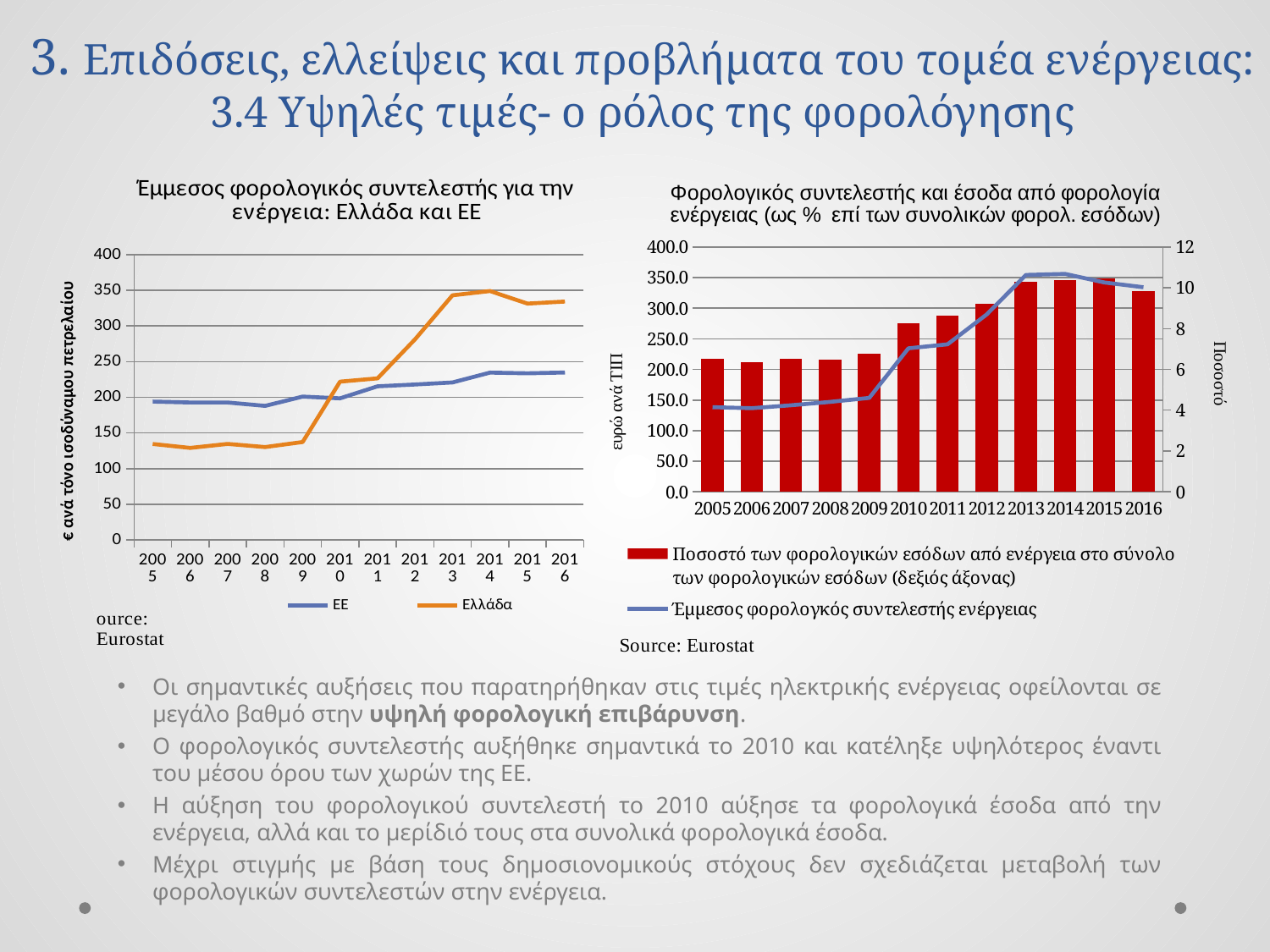
On the left chart (Έμμεσος φορολογικός συντελεστής για την ενέργεια: Ελλάδα και ΕΕ), what kind of chart is it? line chart On the right chart (Φορολογικός συντελεστής και έσοδα από φορολογία ενέργειας), how many series does the legend list? 2 On the right chart (Φορολογικός συντελεστής και έσοδα από φορολογία ενέργειας), is the bar value for 2013 on the right axis greater or less than 8? greater On the left chart (Έμμεσος φορολογικός συντελεστής για την ενέργεια: Ελλάδα και ΕΕ), is the value for Ελλάδα in 2014 greater or less than 300? greater On the left chart (Έμμεσος φορολογικός συντελεστής για την ενέργεια: Ελλάδα και ΕΕ), which series has the higher value in 2005, ΕΕ or Ελλάδα? ΕΕ On the left chart (Έμμεσος φορολογικός συντελεστής για την ενέργεια: Ελλάδα και ΕΕ), how many series does the legend list? 2 On the right chart (Φορολογικός συντελεστής και έσοδα από φορολογία ενέργειας), is the bar value for 2009 on the right axis greater or less than 8? less On the left chart (Έμμεσος φορολογικός συντελεστής για την ενέργεια: Ελλάδα και ΕΕ), which series has the higher value in 2016, ΕΕ or Ελλάδα? Ελλάδα On the left chart (Έμμεσος φορολογικός συντελεστής για την ενέργεια: Ελλάδα και ΕΕ), does the Ελλάδα series rise or fall overall from 2005 to 2016? rise On the left chart (Έμμεσος φορολογικός συντελεστής για την ενέργεια: Ελλάδα και ΕΕ), how many years are shown on the x axis? 12